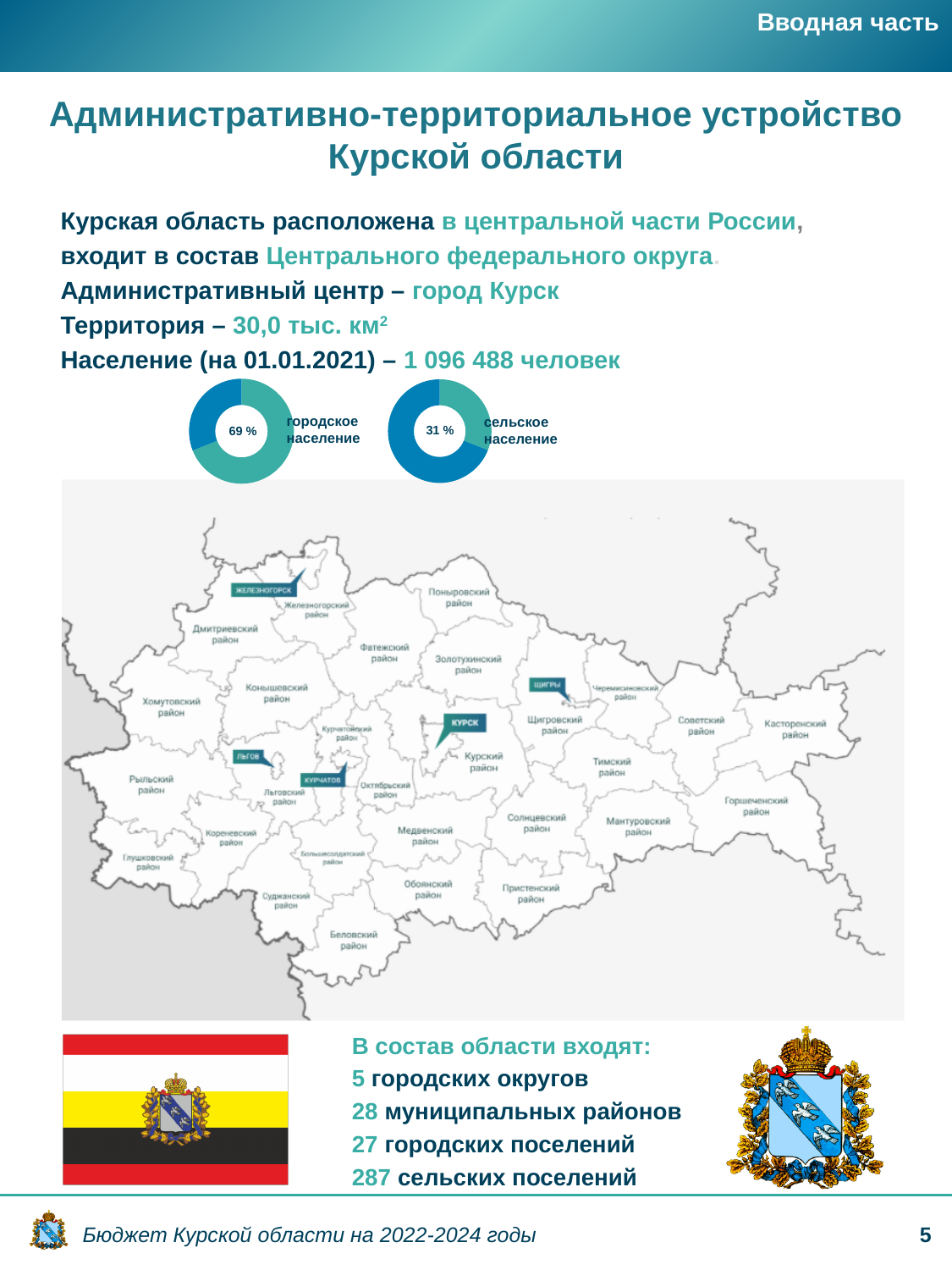
What percentage is shown in the donut chart labelled «городское население»? 69 % What kind of charts are used to show the urban and rural population shares? Donut (pie) charts What label is written next to the left donut chart? городское население By how many percentage points does the share of городское население exceed the share of сельское население? 38 % What percentage is shown in the donut chart labelled «сельское население»? 31 % How many donut charts are shown on the slide? 2 What label is written next to the right donut chart? сельское население Which population share is the smallest of the two shown in the donut charts? сельское население (31 %) What do the shares of городское население and сельское население add up to? 100 % Which is larger, the share of городское население or the share of сельское население? городское население